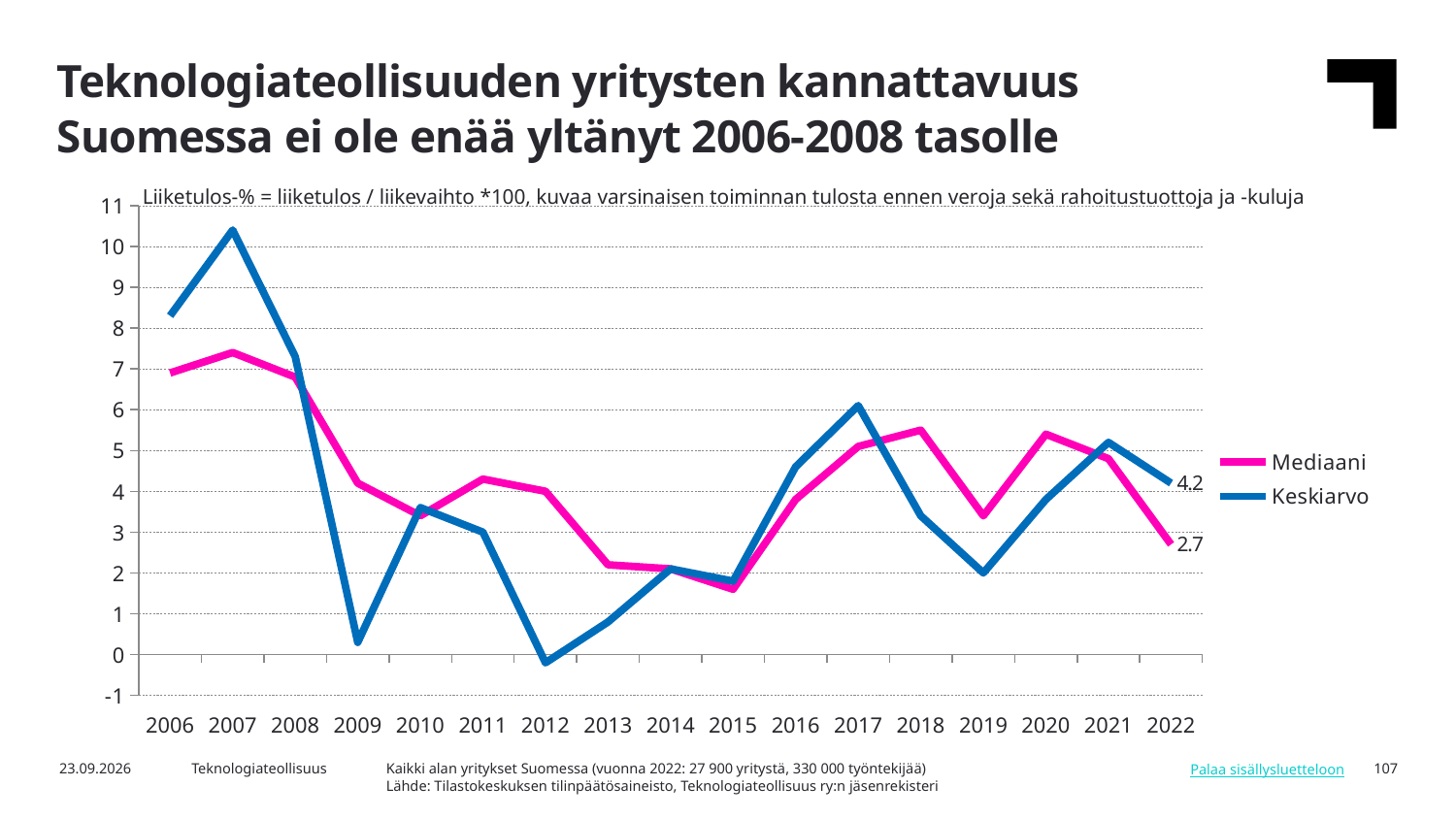
What is the value of Keskiarvo in 2022? 4.2 In which year does the Keskiarvo series reach its lowest value? 2012 What is the value of Mediaani in 2022? 2.7 How many series does the legend list? 2 In 2022, which series has the higher value, Mediaani or Keskiarvo? Keskiarvo What kind of chart is shown on the slide? line chart In which year does the Keskiarvo series reach its highest value? 2007 Does the Mediaani series rise or fall from 2020 to 2022? fall Is the value for Keskiarvo in 2007 greater or less than 9? greater How many years are shown on the x axis? 17 What is the difference between Keskiarvo and Mediaani in 2022? 1.5 Is the value for Keskiarvo in 2009 greater or less than 1? less